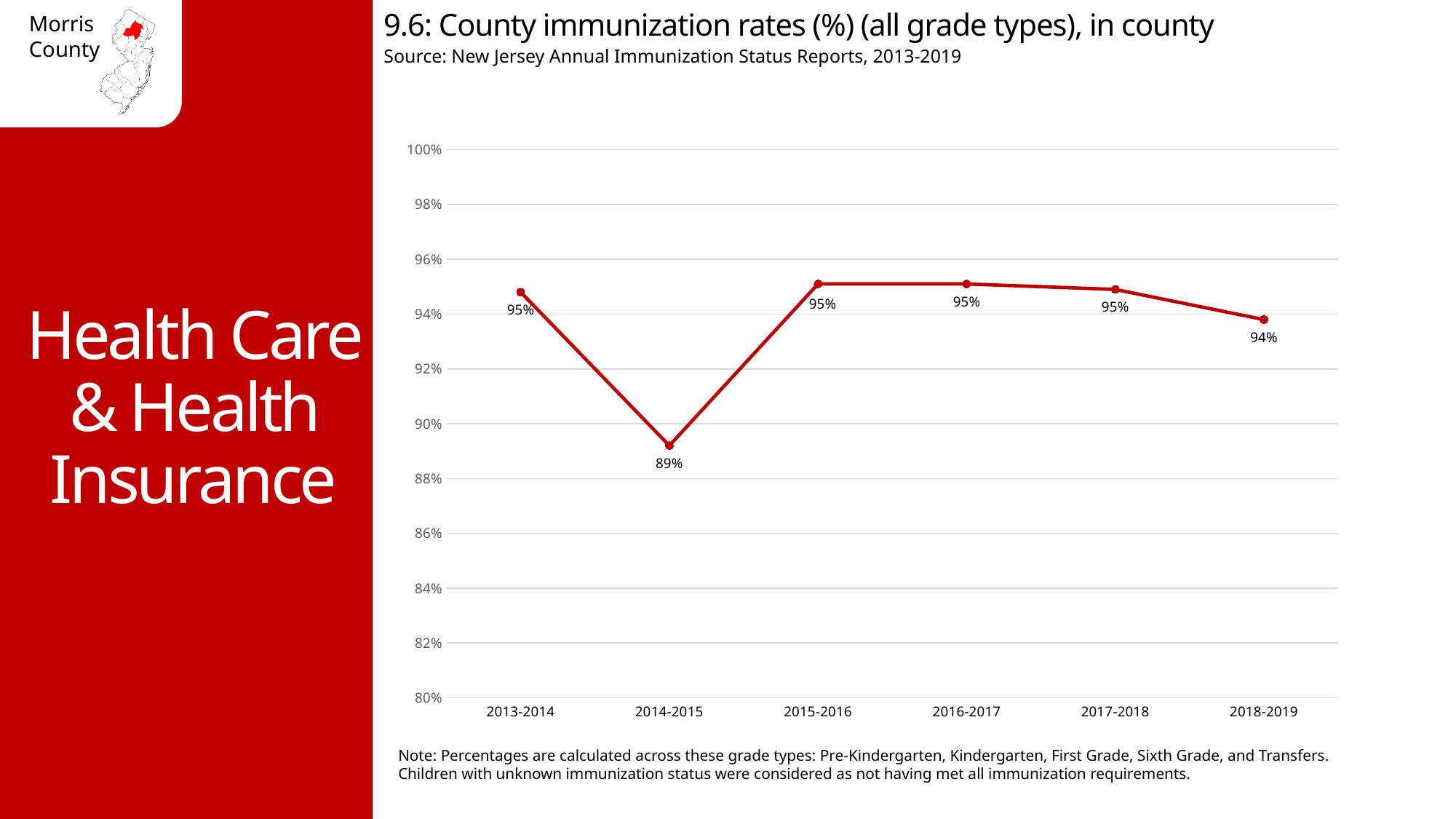
What is the county immunization rate for 2018-2019? 94% What is the difference between the immunization rate in 2015-2016 and in 2014-2015? 6 percentage points How many school years are plotted on the chart? 6 Does the immunization rate rise or fall from 2014-2015 to 2015-2016? rise What kind of chart is shown on the slide? line chart Which year has a higher immunization rate, 2014-2015 or 2018-2019? 2018-2019 What is the source cited for the chart data? New Jersey Annual Immunization Status Reports, 2013-2019 Which school year has the lowest immunization rate? 2014-2015 Is the immunization rate for 2016-2017 greater or less than 94%? greater Is the immunization rate for 2014-2015 greater or less than 90%? less What is the county immunization rate for 2014-2015? 89% What is the county immunization rate for 2013-2014? 95%